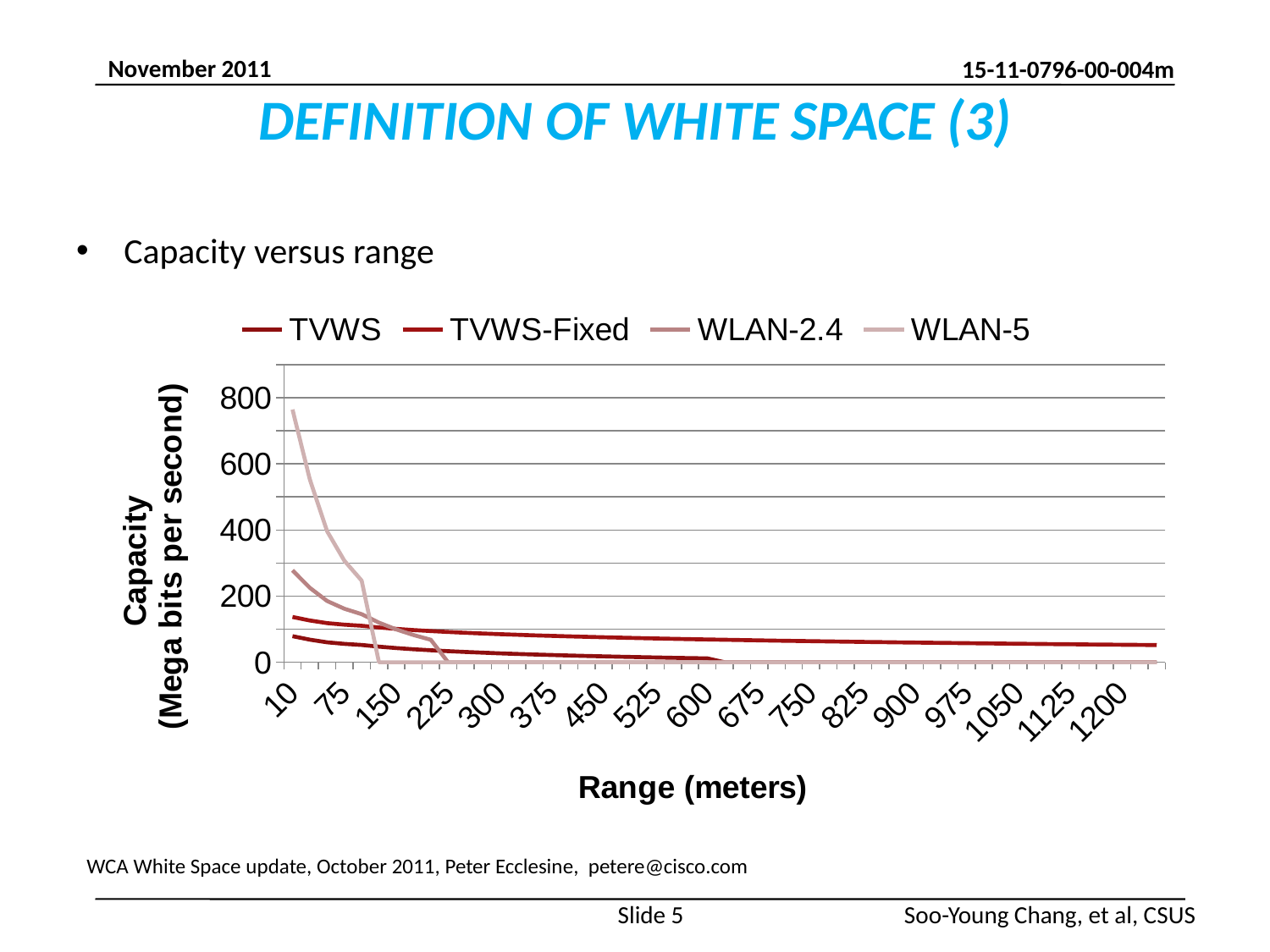
How many series does the legend list? 4 Is the capacity of TVWS-Fixed at 10 meters greater or less than 200? less Which series drops to zero capacity at the shortest range? WLAN-5 How many range tick labels are shown on the x axis? 17 At 10 meters, which has the larger capacity, WLAN-2.4 or TVWS-Fixed? WLAN-2.4 Is the capacity of WLAN-5 at 10 meters greater or less than 600? greater Do the capacity values rise or fall as the range increases along the x axis? Fall What are the series names listed in the legend? TVWS, TVWS-Fixed, WLAN-2.4, WLAN-5 Which series has the highest capacity at a range of 10 meters? WLAN-5 What kind of chart is shown on the slide? Line chart Is the capacity of WLAN-2.4 at 10 meters greater or less than 200? greater At 150 meters, which has the larger capacity, WLAN-2.4 or WLAN-5? WLAN-2.4